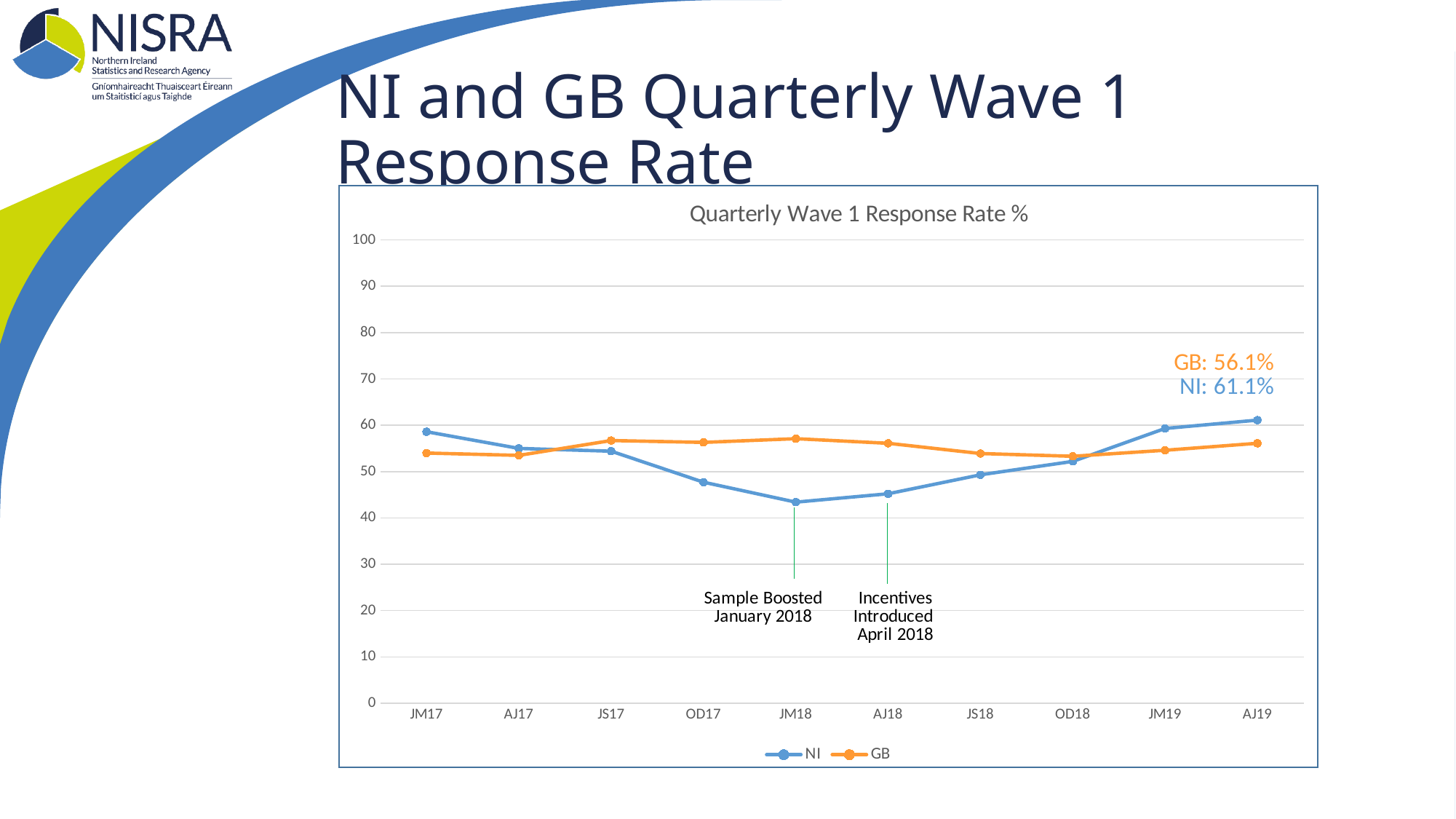
What is the difference between the NI and GB response rates at AJ19? 5.0% At AJ19, which series has the higher response rate, NI or GB? NI Does the NI series rise or fall from JM18 to AJ19? Rise How many quarters are plotted on the x axis? 10 How many series does the legend list? 2 At JM18, which series has the higher response rate, NI or GB? GB What is the NI response rate shown for AJ19? 61.1% Is the NI value for JM18 greater or less than 50? less What is the GB response rate shown for AJ19? 56.1% Is the GB value for JM18 greater or less than 50? greater At which quarter does the NI series reach its lowest point? JM18 What kind of chart is shown on the slide? Line chart